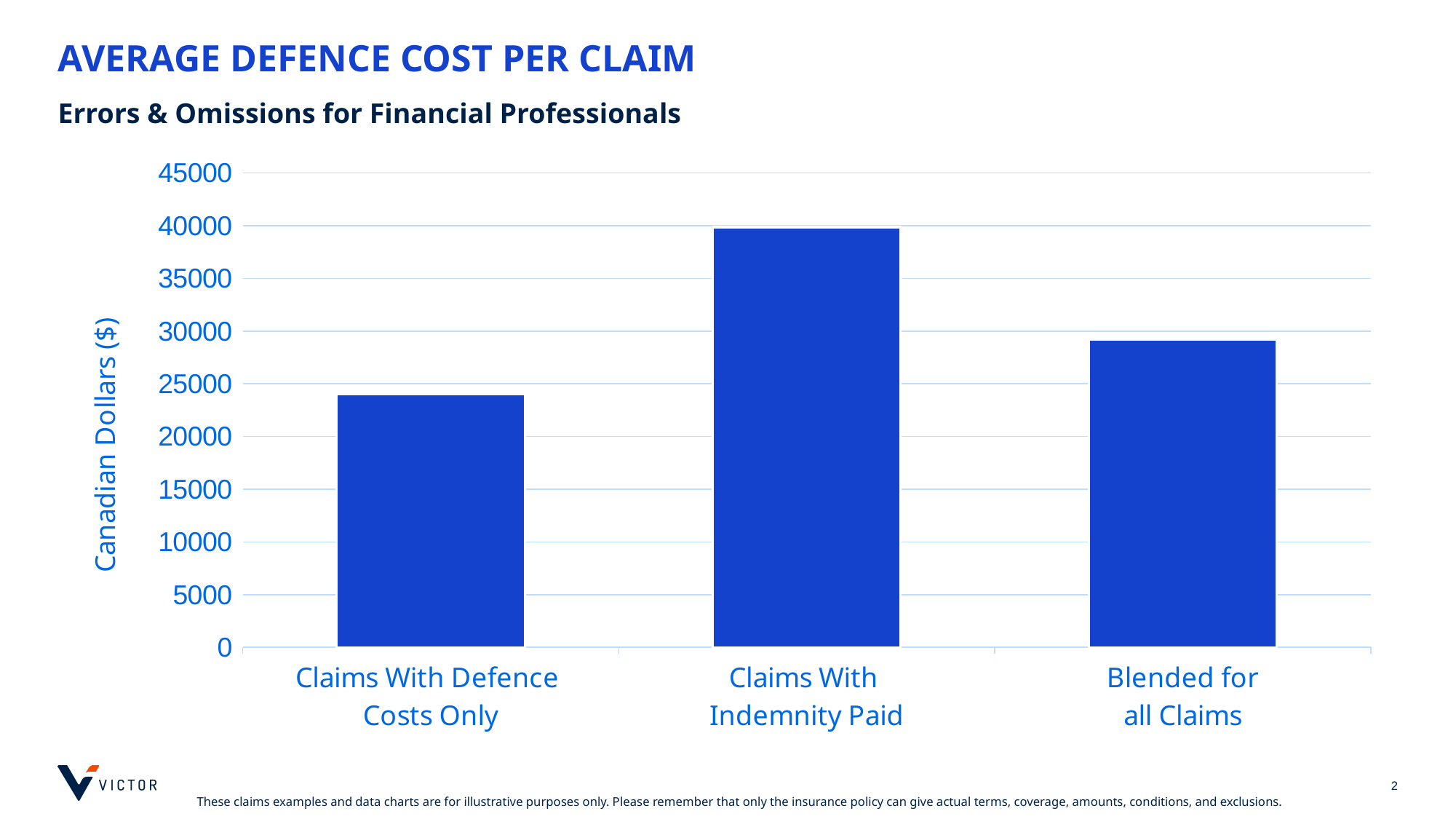
Which is larger: the value for Blended for all Claims or the value for Claims With Defence Costs Only? Blended for all Claims What is the label of the vertical axis? Canadian Dollars ($) What kind of chart is shown on the slide? bar chart Is the value for Blended for all Claims greater or less than 25000? greater Which category has the lowest average defence cost per claim? Claims With Defence Costs Only Which category has the highest average defence cost per claim? Claims With Indemnity Paid How many categories are plotted in the chart? 3 Is the value for Claims With Defence Costs Only greater or less than 30000? less Is the value for Claims With Indemnity Paid greater or less than 35000? greater Which is larger: the value for Claims With Indemnity Paid or the value for Blended for all Claims? Claims With Indemnity Paid What is the title of the chart on the slide? AVERAGE DEFENCE COST PER CLAIM